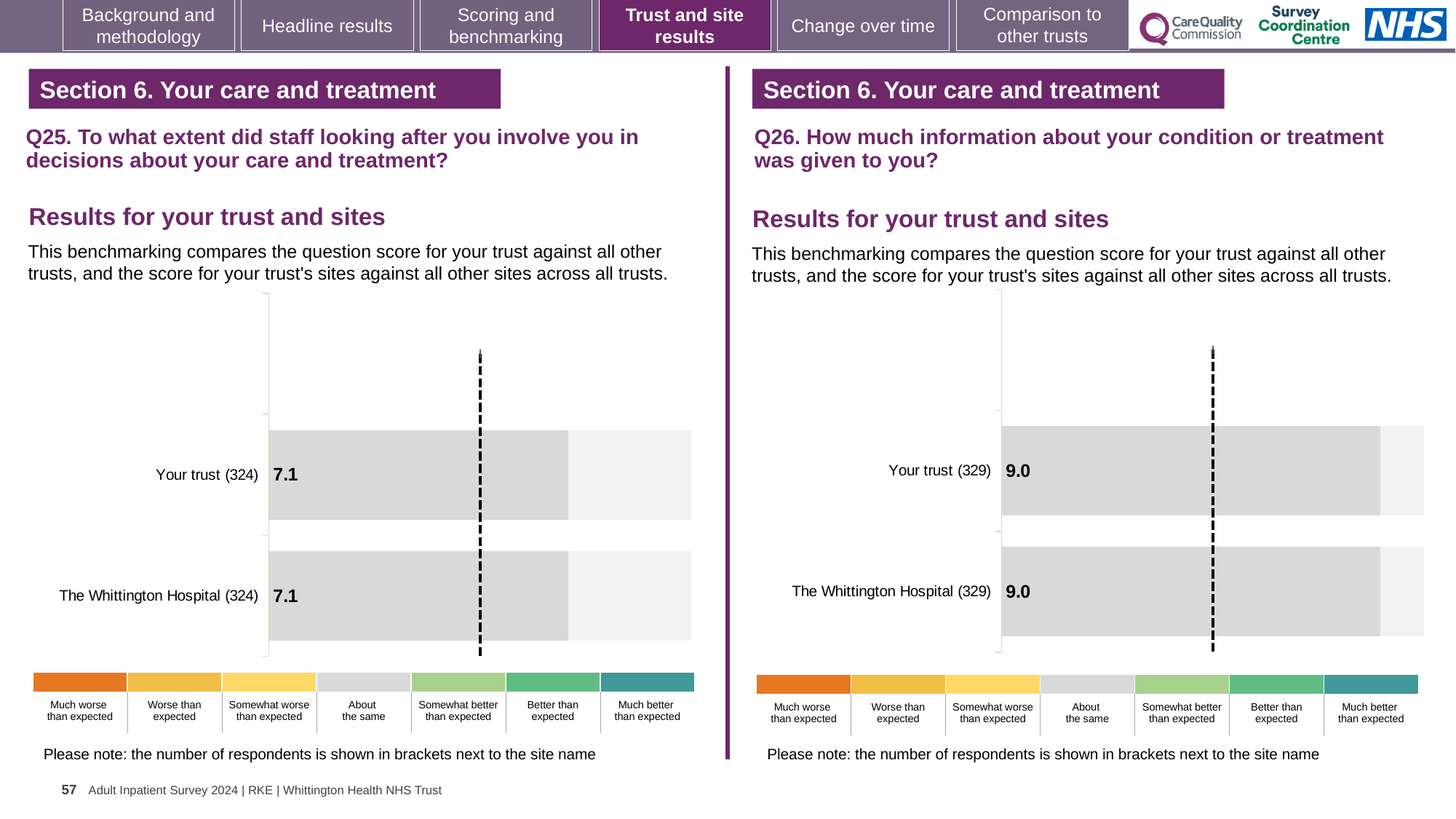
How many bars are plotted in the Q26 chart on the right? 2 In the Q26 chart on the right, how many respondents are shown in brackets for The Whittington Hospital? 329 In the Q25 chart on the left, what is the score for The Whittington Hospital? 7.1 How many bars are plotted in the Q25 chart on the left? 2 In the Q26 chart on the right, what is the difference between the score for Your trust and the score for The Whittington Hospital? 0.0 In the Q25 chart on the left, what is the difference between the score for Your trust and the score for The Whittington Hospital? 0.0 In the Q26 chart on the right, what is the score for Your trust? 9.0 In the Q25 chart on the left, what is the score for Your trust? 7.1 In the Q26 chart on the right, what is the score for The Whittington Hospital? 9.0 What kind of chart is used for the Q25 results on the left? Bar chart In the Q25 chart on the left, how many respondents are shown in brackets for Your trust? 324